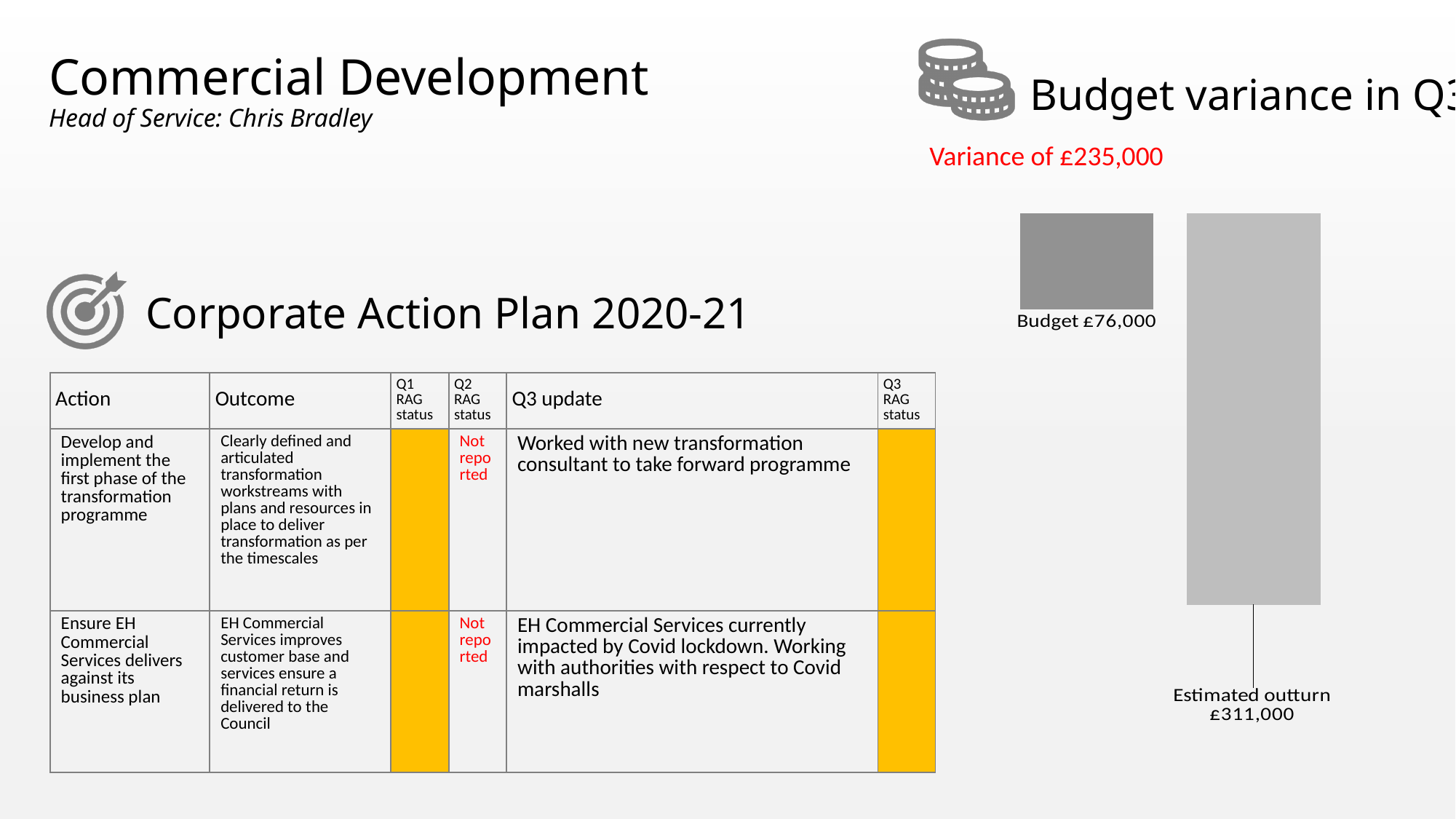
What is the value of the Estimated outturn bar in the budget variance chart? £311,000 What is the value of the Budget bar in the budget variance chart? £76,000 What is the difference between the Estimated outturn and the Budget in the budget variance chart? £235,000 Which bar in the budget variance chart is taller, Budget or Estimated outturn? Estimated outturn Which category has the highest value in the budget variance chart? Estimated outturn What variance amount is stated above the budget variance chart? £235,000 Which quarter does the budget variance chart refer to? Q3 What kind of chart is used to show the budget variance? Bar chart How many bars are shown in the budget variance chart? 2 Which category has the lowest value in the budget variance chart? Budget